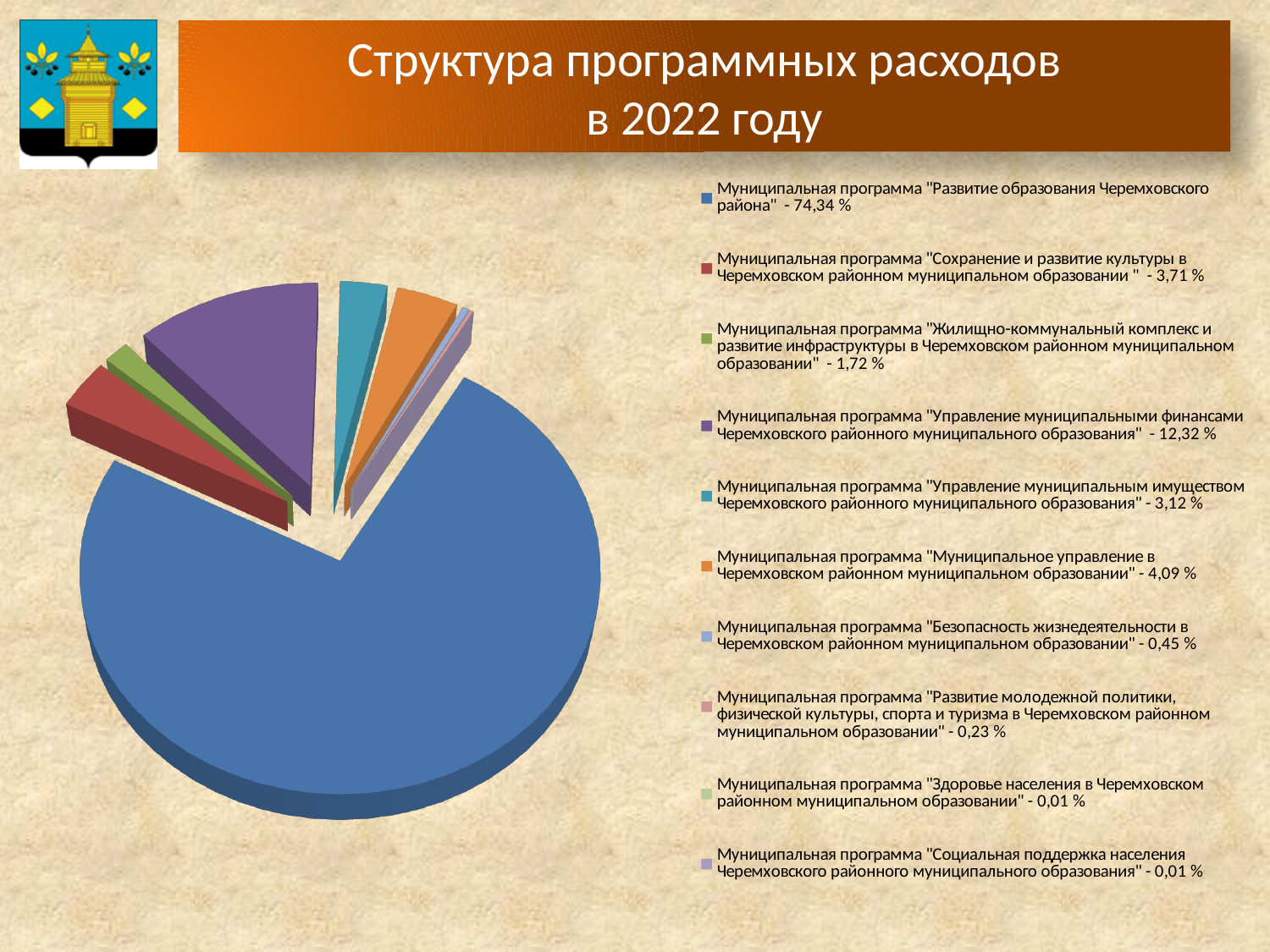
What colour is the slice for the programme "Развитие образования Черемховского района"? Blue What is the title of the chart on the slide? Структура программных расходов в 2022 году What share of programme expenditure goes to the programme "Развитие образования Черемховского района"? 74,34 % What type of chart is shown on the slide? Pie chart What is the difference between the share for "Управление муниципальными финансами" and the share for "Управление муниципальным имуществом"? 9,20 % What share is shown for the programme "Сохранение и развитие культуры в Черемховском районном муниципальном образовании"? 3,71 % Which is larger: the share for "Муниципальное управление" or the share for "Управление муниципальным имуществом"? Муниципальное управление How many programmes (slices) does the legend list? 10 What share is shown for the programme "Безопасность жизнедеятельности в Черемховском районном муниципальном образовании"? 0,45 % Which programme has the largest share of programme expenditure? Муниципальная программа "Развитие образования Черемховского района" What share is shown for the programme "Управление муниципальными финансами Черемховского районного муниципального образования"? 12,32 % What is the difference in percentage points between the share for "Развитие образования Черемховского района" and the share for "Управление муниципальными финансами"? 62,02 %